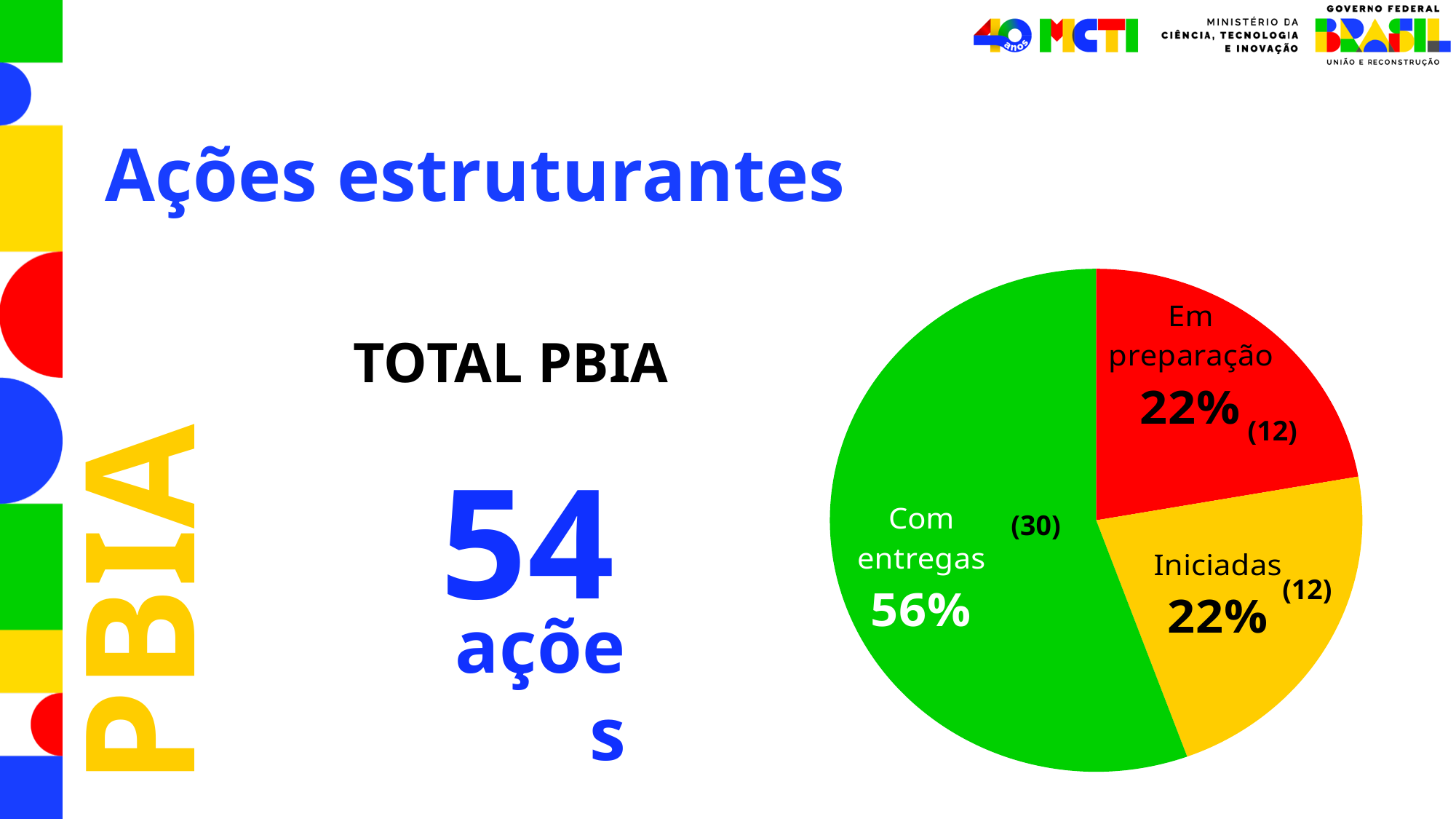
How many actions are in the "Com entregas" slice? 30 What percentage of the pie is labelled "Iniciadas"? 22% What is the total number of actions shown as TOTAL PBIA on the slide? 54 What percentage of the pie is labelled "Com entregas"? 56% What colour is the "Com entregas" slice of the pie chart? green How many slices does the pie chart have? 3 What kind of chart is shown on the slide? pie chart How many actions are in the "Iniciadas" slice? 12 Which slice of the pie chart is the largest? Com entregas How many actions are in the "Em preparação" slice? 12 What percentage of the pie is labelled "Em preparação"? 22% What is the difference in number of actions between "Com entregas" and "Iniciadas"? 18